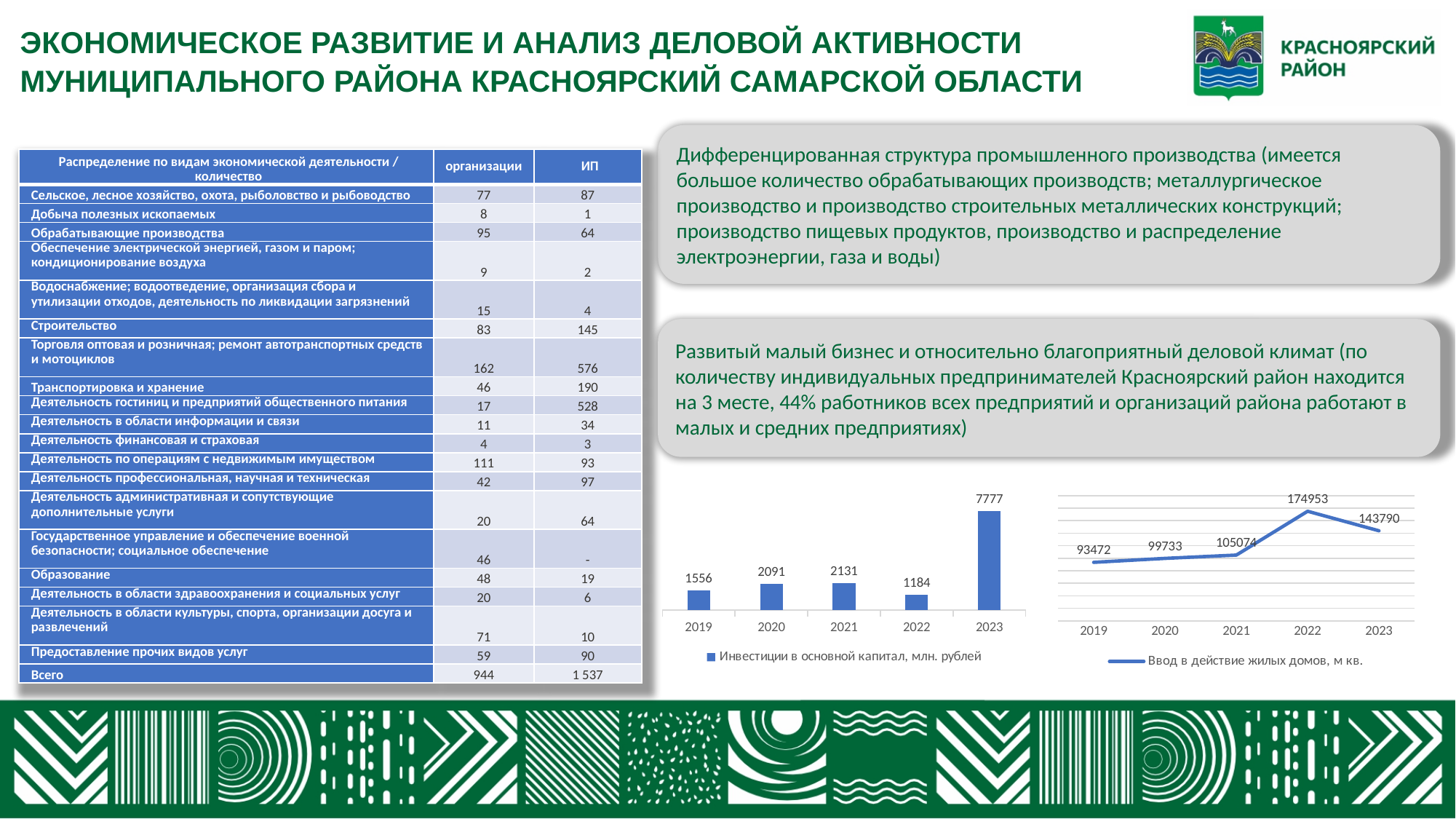
In the line chart on the right (Ввод в действие жилых домов, м кв.), what is the value for 2019? 93472 In the line chart on the right (Ввод в действие жилых домов, м кв.), is the value for 2023 larger or smaller than the value for 2022? smaller In the bar chart on the left (Инвестиции в основной капитал, млн. рублей), what is the value for 2020? 2091 In the bar chart on the left (Инвестиции в основной капитал, млн. рублей), how many years are shown? 5 In the bar chart on the left (Инвестиции в основной капитал, млн. рублей), which year has the highest value? 2023 In the bar chart on the left (Инвестиции в основной капитал, млн. рублей), what is the difference between the values for 2021 and 2019? 575 In the bar chart on the left (Инвестиции в основной капитал, млн. рублей), which year has the lowest value? 2022 What type of chart is the chart on the left showing Инвестиции в основной капитал? bar chart In the line chart on the right (Ввод в действие жилых домов, м кв.), what is the difference between the values for 2021 and 2020? 5341 In the bar chart on the left (Инвестиции в основной капитал, млн. рублей), what is the value for 2023? 7777 In the line chart on the right (Ввод в действие жилых домов, м кв.), which year has the highest value? 2022 In the line chart on the right (Ввод в действие жилых домов, м кв.), what is the value for 2022? 174953